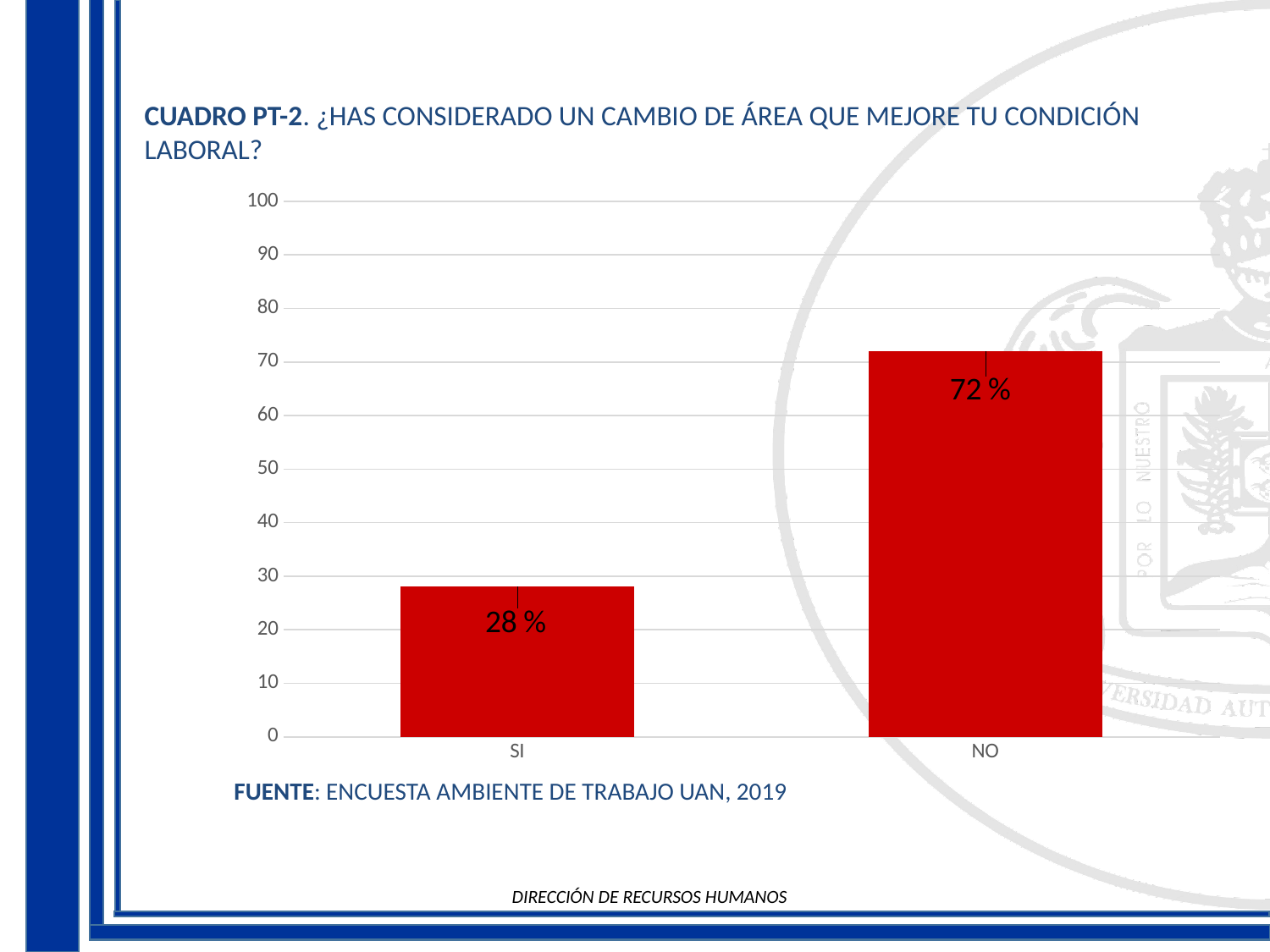
What is the difference between the values for NO and SI? 44 % Is the value for NO greater or less than 50? greater How many categories are shown on the x axis? 2 Which category has the highest value? NO What is the source cited below the chart? ENCUESTA AMBIENTE DE TRABAJO UAN, 2019 What colour are the bars in the chart? red Is the value for SI greater or less than 30? less What is the value for SI? 28 % What kind of chart is shown on the slide? bar chart Which category has the lowest value? SI What is the value for NO? 72 % Which is larger, the value for SI or the value for NO? NO